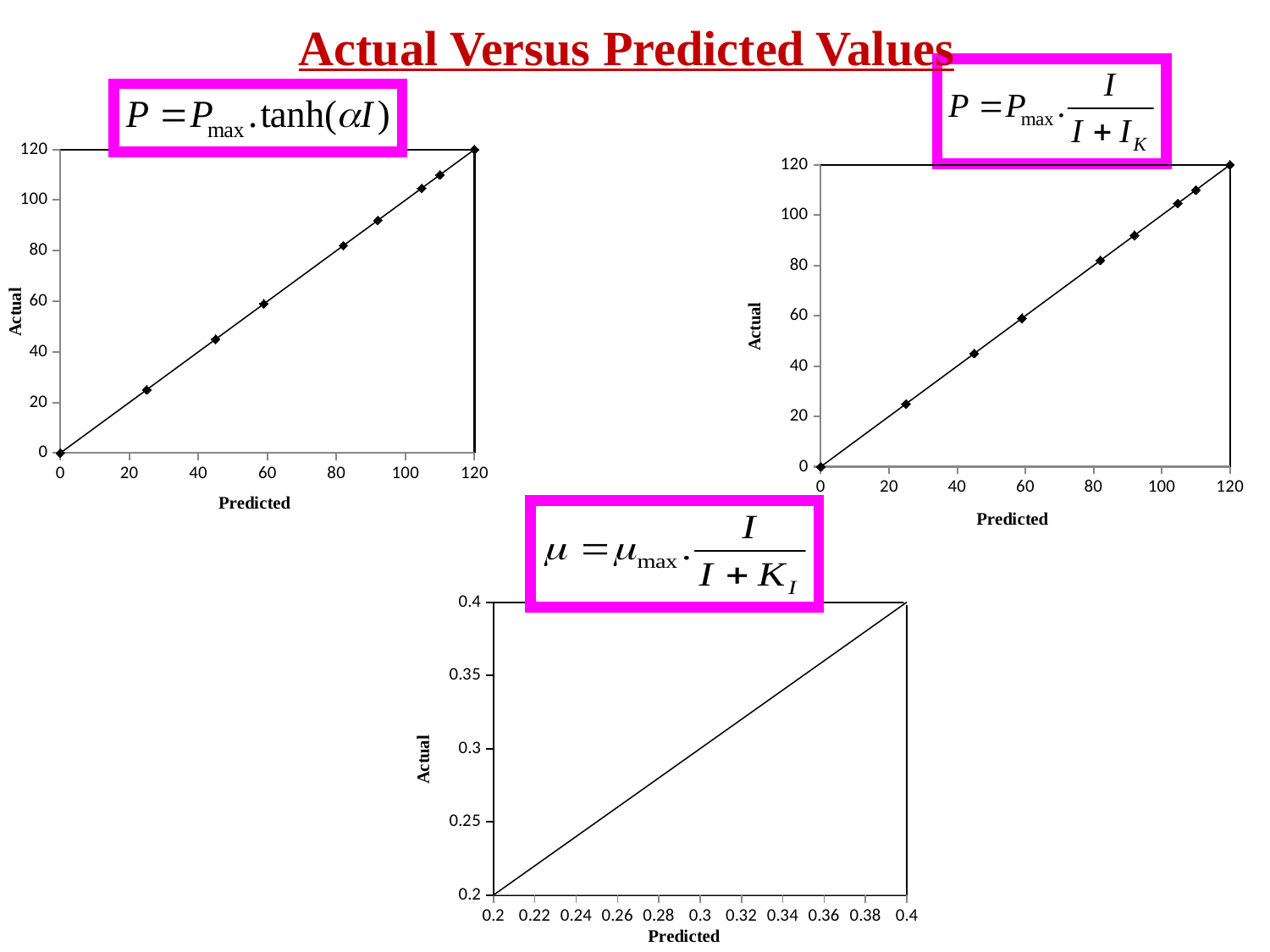
What kind of chart is the top-left chart on the slide? scatter chart with a line In the top-left chart, do the Actual values rise or fall as Predicted increases? rise In the top-right chart, what is the label of the y axis? Actual In the bottom chart, does the line rise or fall as Predicted increases from 0.2 to 0.4? rise In the top-left chart, what is the label of the x axis? Predicted How many data points are plotted in the top-right chart? 9 In the top-right chart, what is the highest Predicted value plotted? 120 In the top-right chart, do the Actual values rise or fall as Predicted increases? rise In the top-left chart, what is the highest Actual value plotted? 120 In the bottom chart, what is the highest value shown on the y axis? 0.4 In the top-left chart, what is the lowest Actual value plotted? 0 How many data points are plotted in the top-left chart? 9